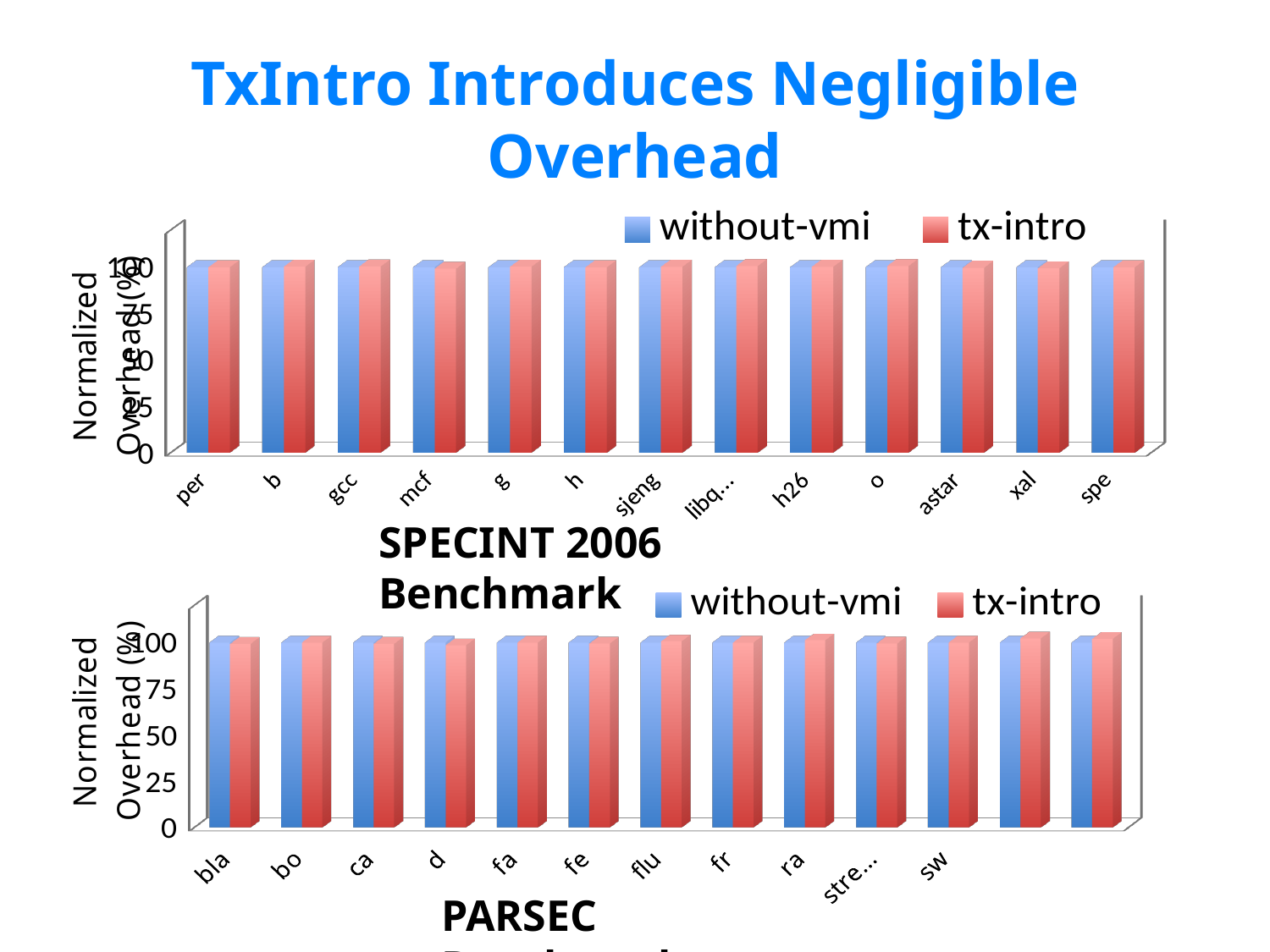
What kind of chart is the SPECINT 2006 Benchmark chart at the top of the slide? bar chart In the PARSEC Benchmark chart, is the without-vmi value for sw greater or less than 50? greater In the PARSEC Benchmark chart, is the tx-intro value for bla greater or less than 75? greater How many series does the legend of the PARSEC Benchmark chart list? 2 What are the two legend entries in the PARSEC Benchmark chart? without-vmi and tx-intro How many benchmark categories are shown on the x axis of the SPECINT 2006 Benchmark chart? 13 In the PARSEC Benchmark chart, what is the highest tick value shown on the y axis? 100 How many series does the legend of the SPECINT 2006 Benchmark chart list? 2 How many benchmark categories are shown on the x axis of the PARSEC Benchmark chart? 13 In the SPECINT 2006 Benchmark chart, is the tx-intro value for gcc greater or less than 50? greater What is the y-axis title of the PARSEC Benchmark chart? Normalized Overhead (%) What kind of chart is the PARSEC Benchmark chart at the bottom of the slide? bar chart